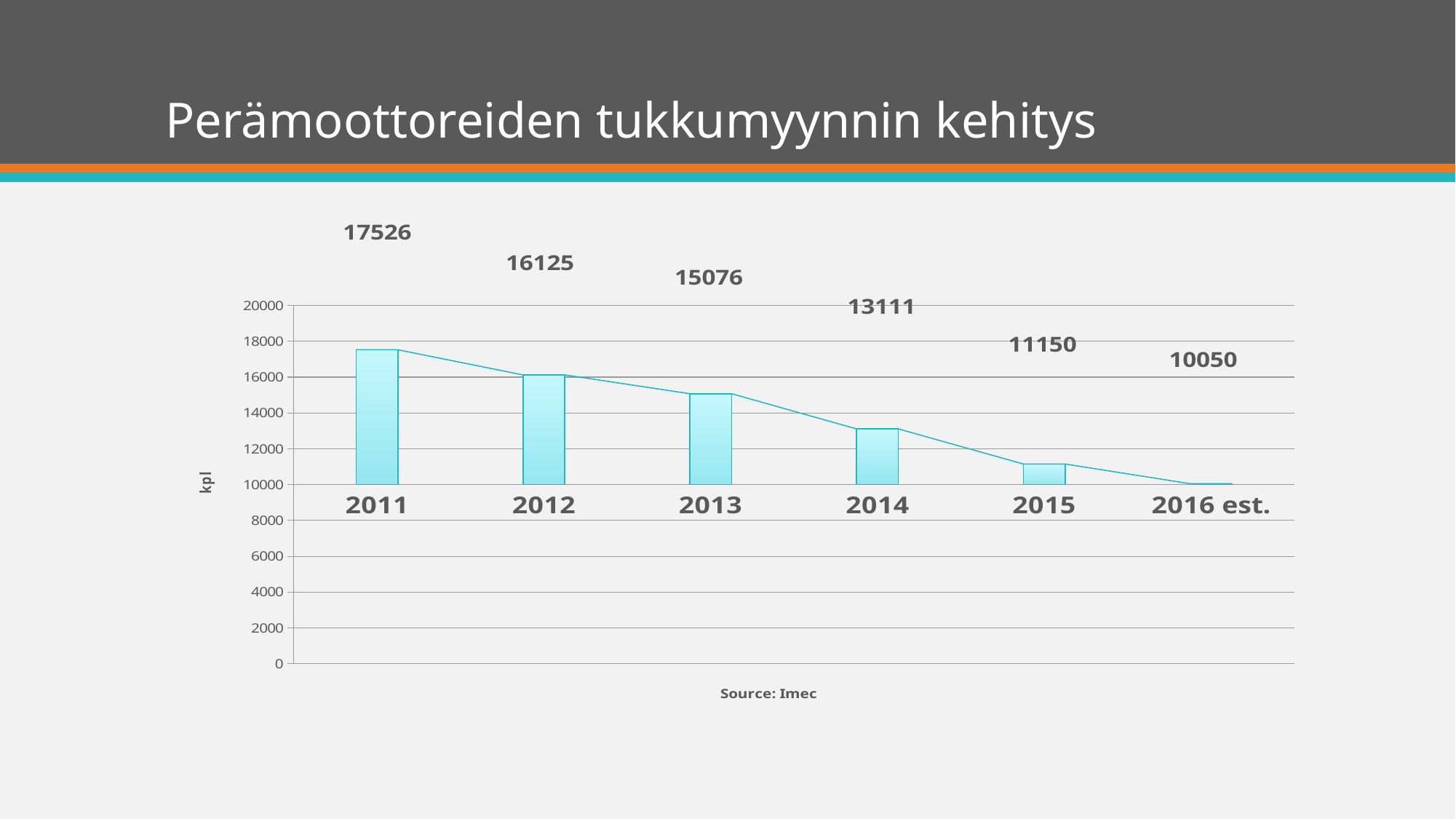
What is the label on the vertical axis? kpl Which year has the highest value? 2011 Do the values rise or fall from 2011 to 2016 est.? fall What is the value for 2014? 13111 What is the difference between the values for 2011 and 2012? 1401 Which is larger, the value for 2013 or the value for 2015? 2013 How many categories are shown on the x axis? 6 What is the difference between the values for 2014 and 2015? 1961 Which category has the lowest value? 2016 est. What is the value for 2016 est.? 10050 Is the value for 2012 greater or less than 16000? greater What is the value for 2011? 17526